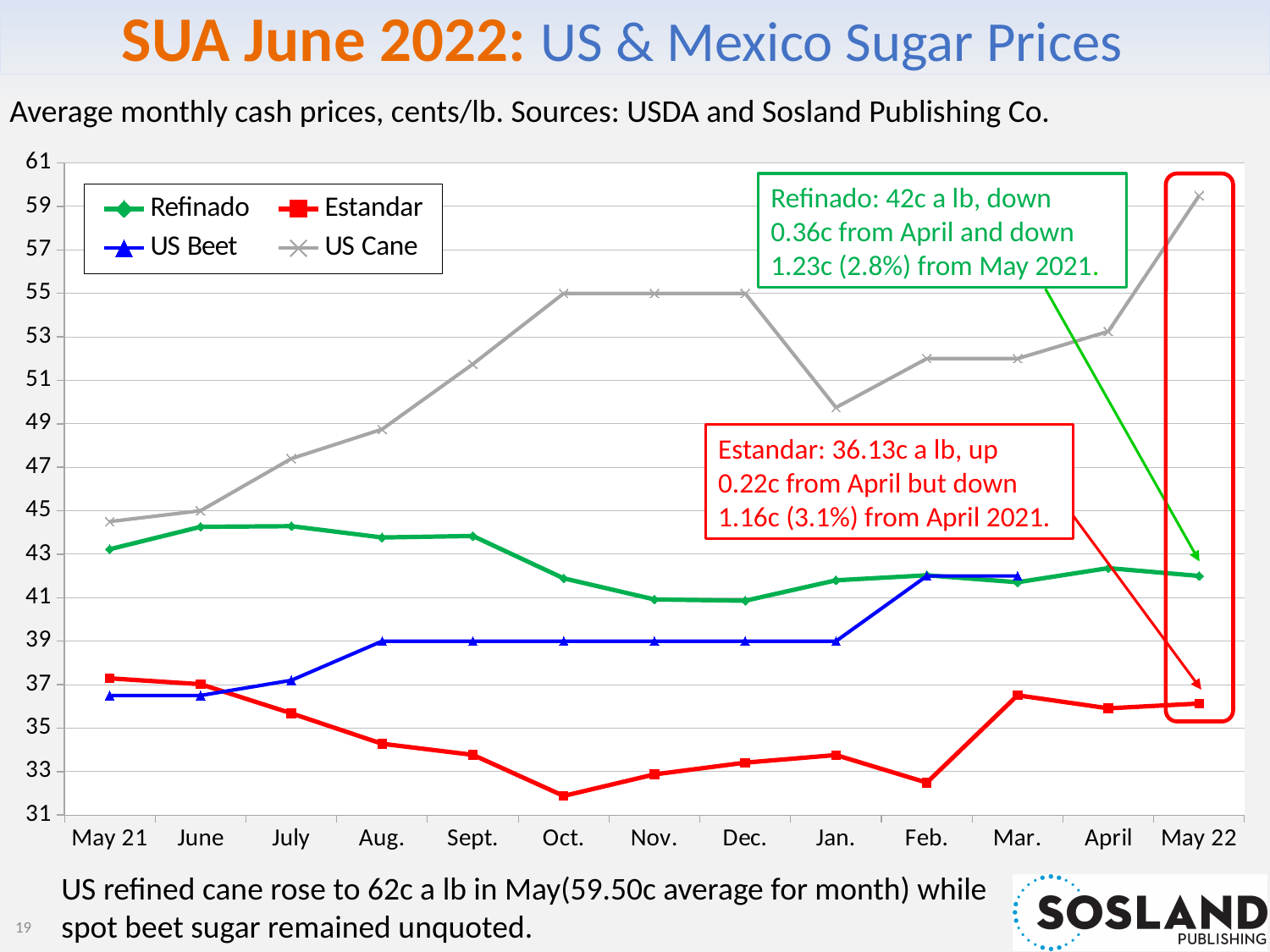
According to the annotation, what was the Refinado price in May 2022? 42c a lb How many series does the chart legend list? 4 Is the value for US Cane in Oct. greater or less than 53? greater Which series has the lowest value in May 22? Estandar How many months are shown along the x axis of the chart? 13 Does the US Cane series rise or fall from May 21 to Oct.? rise In Aug., which is larger: Refinado or US Beet? Refinado What kind of chart is shown on the slide? line chart What is the difference between the Refinado and Estandar prices in May 2022, using the values in the annotations? 5.87c According to the annotation, what was the Estandar price in May 2022? 36.13c a lb Is the value for Estandar in Oct. greater or less than 33? less Which series has the highest value in May 22? US Cane